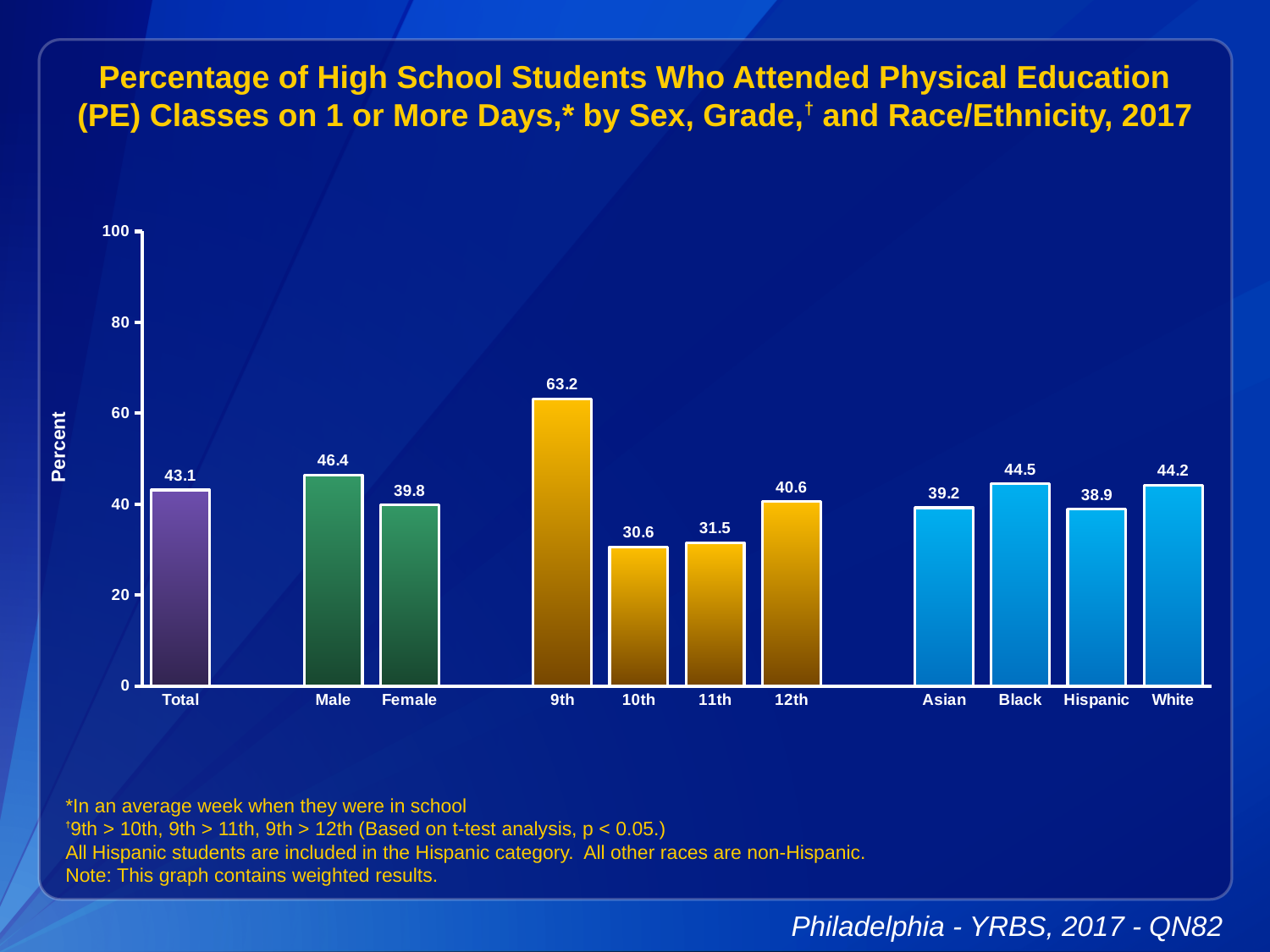
What kind of chart is shown on the slide? bar chart What is the value for Total? 43.1 What percentage of 9th grade students attended PE classes on 1 or more days? 63.2 How many categories are shown on the x axis? 11 What is the difference between the Male and Female values? 6.6 Which category has the lowest value? 10th What is the value for Hispanic students? 38.9 Which category has the highest value? 9th What is the label of the y axis? Percent Which is larger, the value for Black students or the value for White students? Black What is the difference between the 9th and 12th grade values? 22.6 Is the value for 11th grade greater or less than 40? less